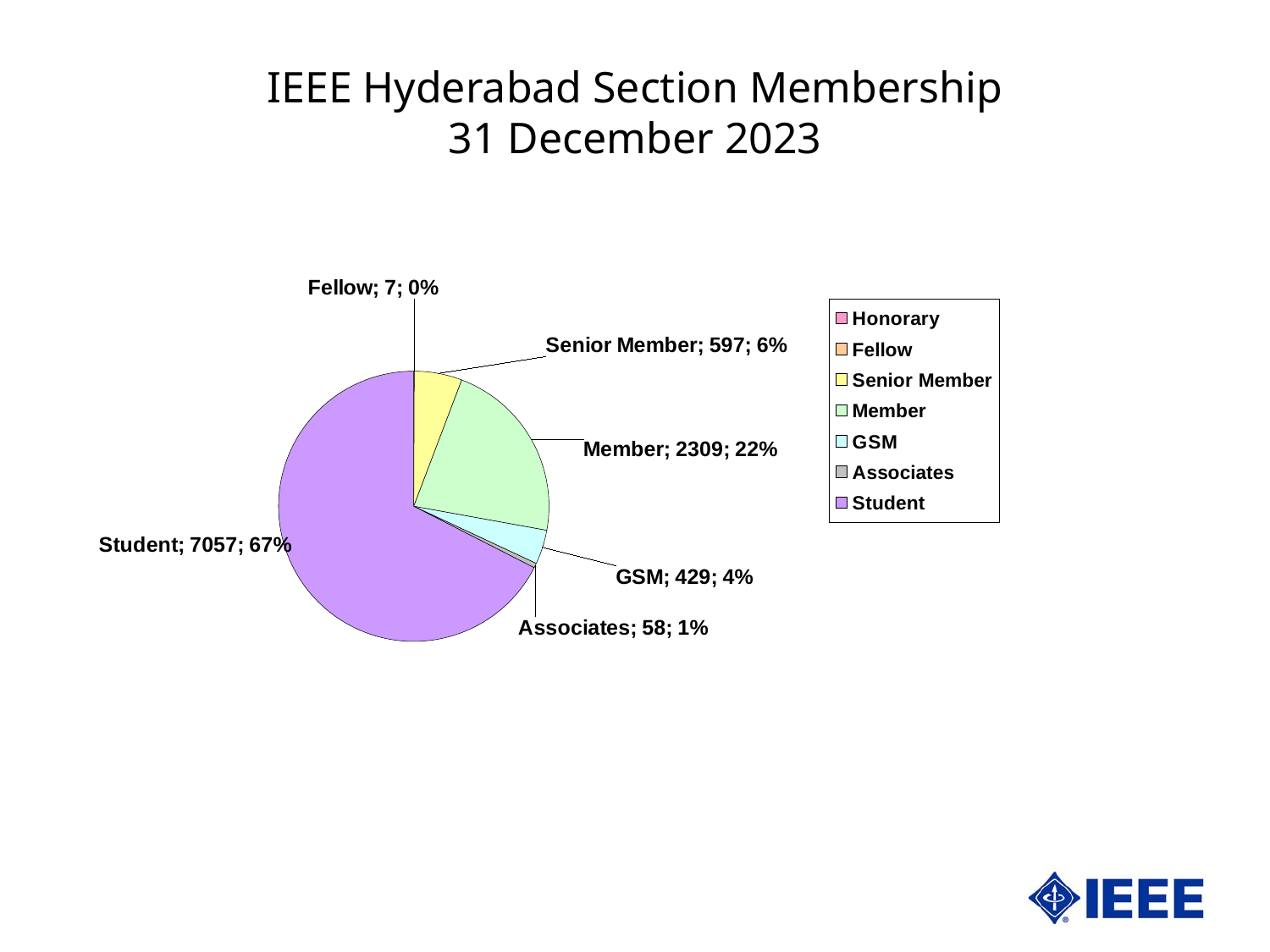
What is the value shown for GSM? 429 How many members does the Student slice represent? 7057 What is the value shown for Senior Member? 597 What percentage share of the pie does the Member slice have? 22% What is the value shown for Member? 2309 Which category has the largest slice of the pie? Student What type of chart is shown on the slide? Pie chart What percentage share of the pie does the Student slice have? 67% What is the difference between the Member value and the Senior Member value? 1712 Which labelled category has the smallest value? Fellow How many entries does the legend list? 7 Which is larger, the GSM value or the Associates value? GSM